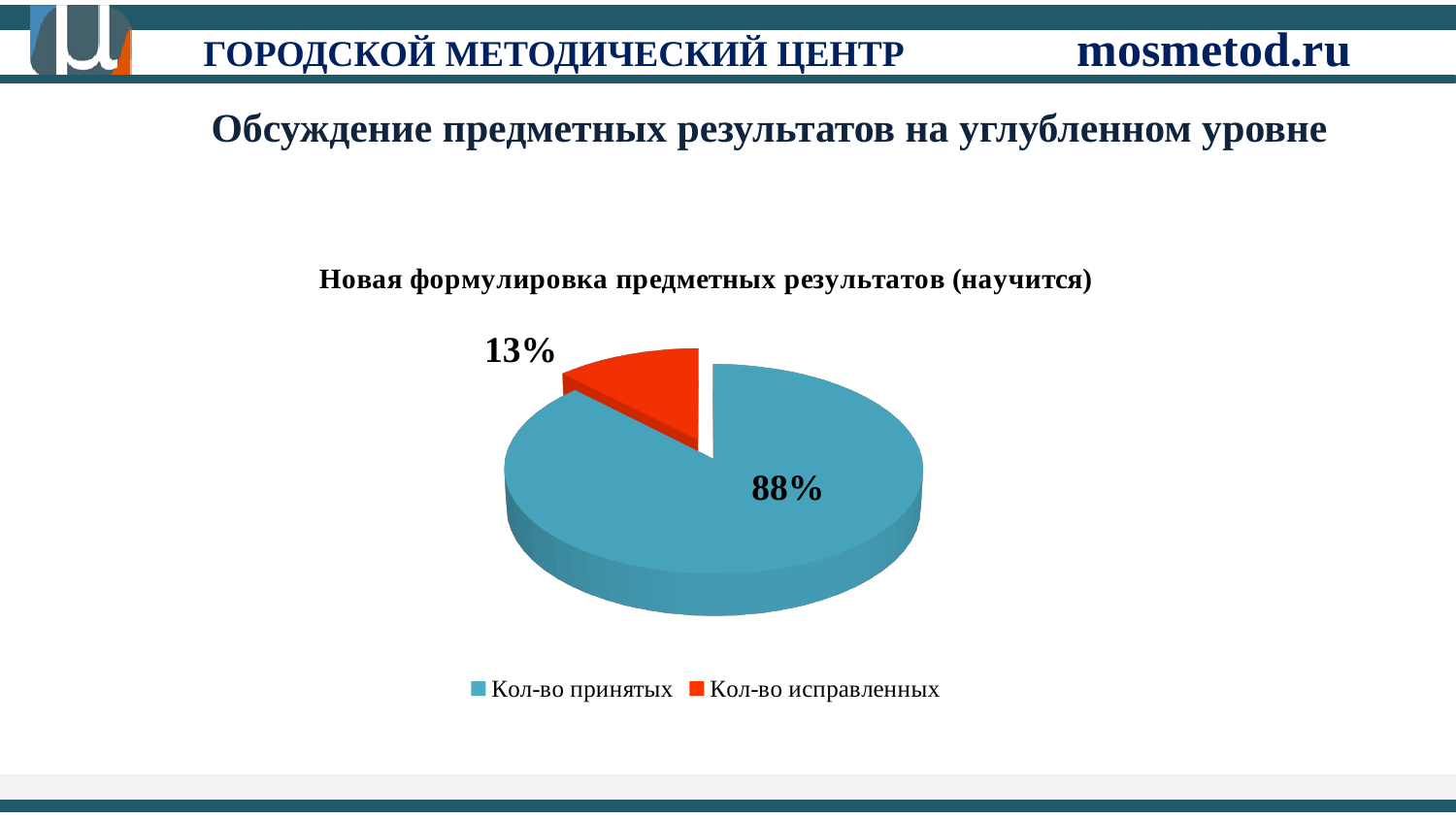
Which slice is the largest? Кол-во принятых Which is larger, "Кол-во принятых" or "Кол-во исправленных"? Кол-во принятых Which slice is the smallest? Кол-во исправленных What colour is the "Кол-во исправленных" slice? red How many slices does the pie chart have? 2 What share of the pie does "Кол-во принятых" take? 88% What is the title of the chart? Новая формулировка предметных результатов (научится) How many entries does the legend list? 2 What share of the pie does "Кол-во исправленных" take? 13% What is the difference in percentage points between the "Кол-во принятых" and "Кол-во исправленных" slices? 75 What kind of chart is shown on the slide? pie chart